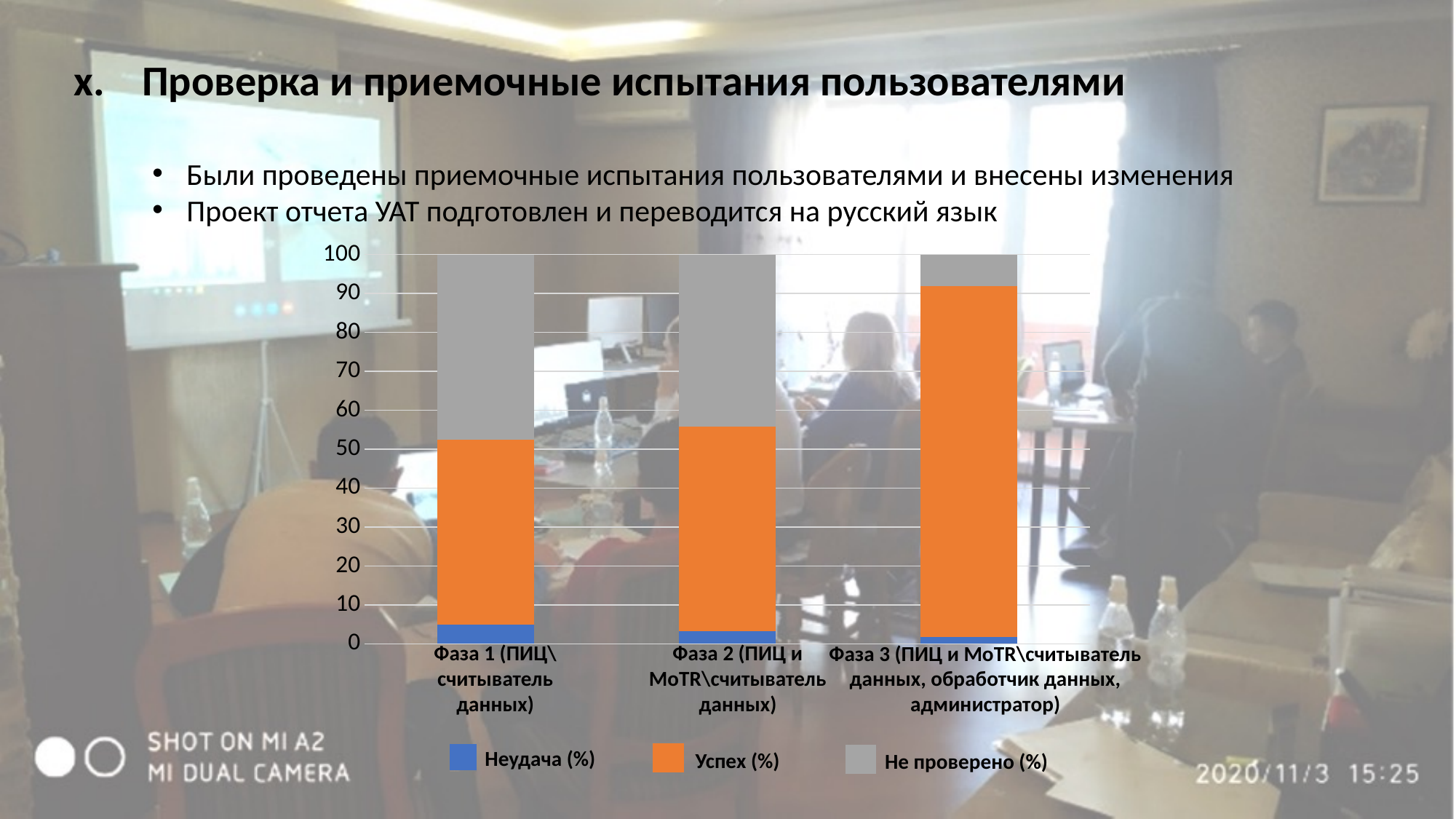
Which phase has the largest Успех (%) segment? Фаза 3 (ПИЦ и MoTR\считыватель данных, обработчик данных, администратор) Is the Успех (%) segment larger for Фаза 3 or for Фаза 1? Фаза 3 How many series does the chart legend list? 3 How many phases (categories) are shown on the x axis of the chart? 3 What is the total height of the stacked bar for Фаза 1? 100 Is the top of the Успех (%) segment for Фаза 2 greater or less than 50? greater Is the top of the Успех (%) segment for Фаза 1 greater or less than 60? less Does the Успех (%) share rise or fall from Фаза 1 to Фаза 3? Rise Which phase has the largest Неудача (%) segment? Фаза 1 (ПИЦ\считыватель данных) Is the top of the Успех (%) segment for Фаза 3 greater or less than 80? greater What kind of chart is shown on the slide? Stacked bar chart Which phase has the smallest Не проверено (%) segment? Фаза 3 (ПИЦ и MoTR\считыватель данных, обработчик данных, администратор)